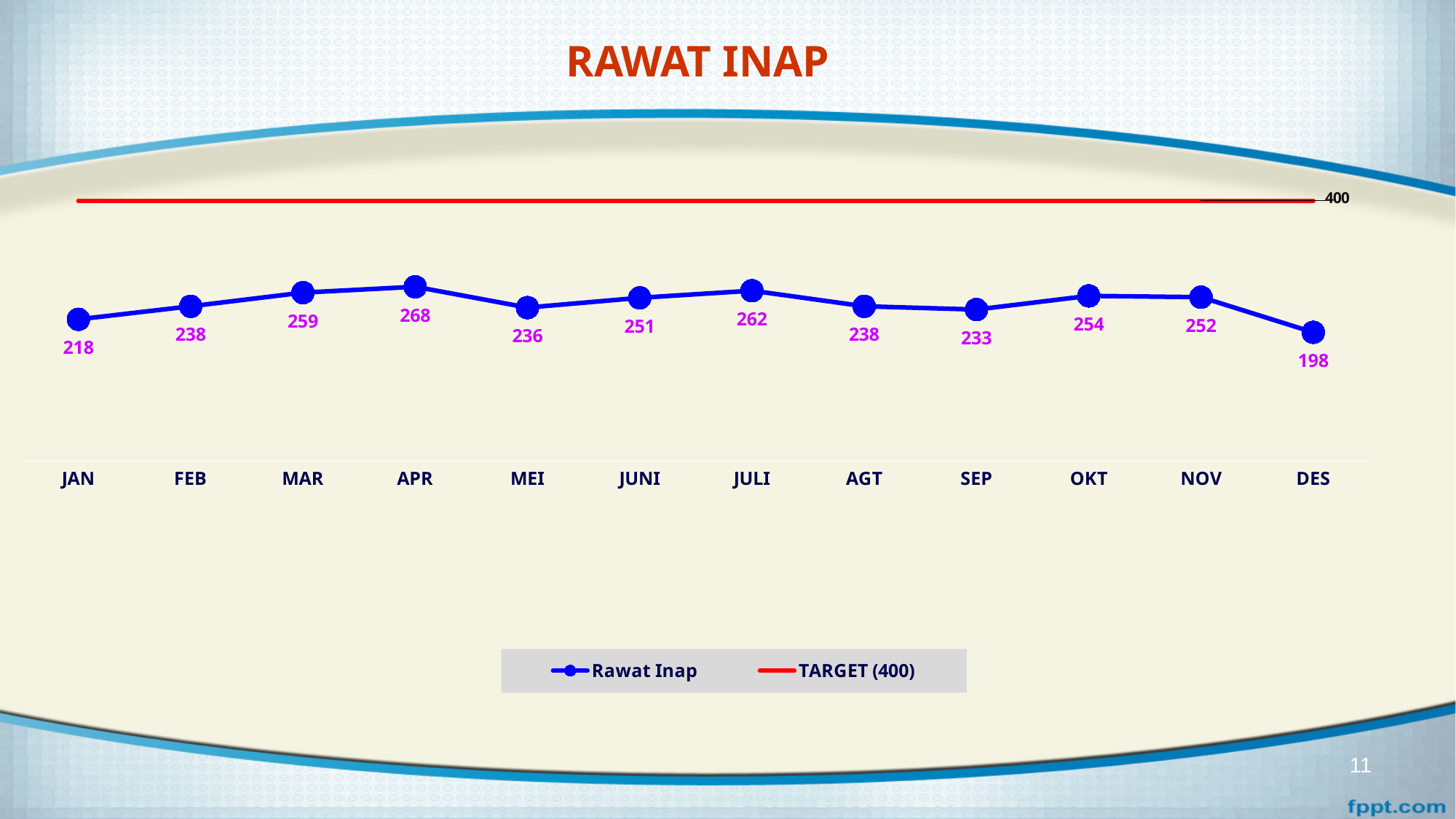
What is the value of the TARGET line? 400 What kind of chart is shown on the slide? Line chart Which month has the highest Rawat Inap value? APR What is the Rawat Inap value for SEP? 233 What is the Rawat Inap value for APR? 268 Which is larger, the Rawat Inap value for MAR or for OKT? MAR Which month has the lowest Rawat Inap value? DES What is the Rawat Inap value for DES? 198 How many series does the legend list? 2 What is the difference between the Rawat Inap values for JULI and JUNI? 11 What is the difference between the Rawat Inap values for APR and DES? 70 How many months are plotted on the x axis? 12